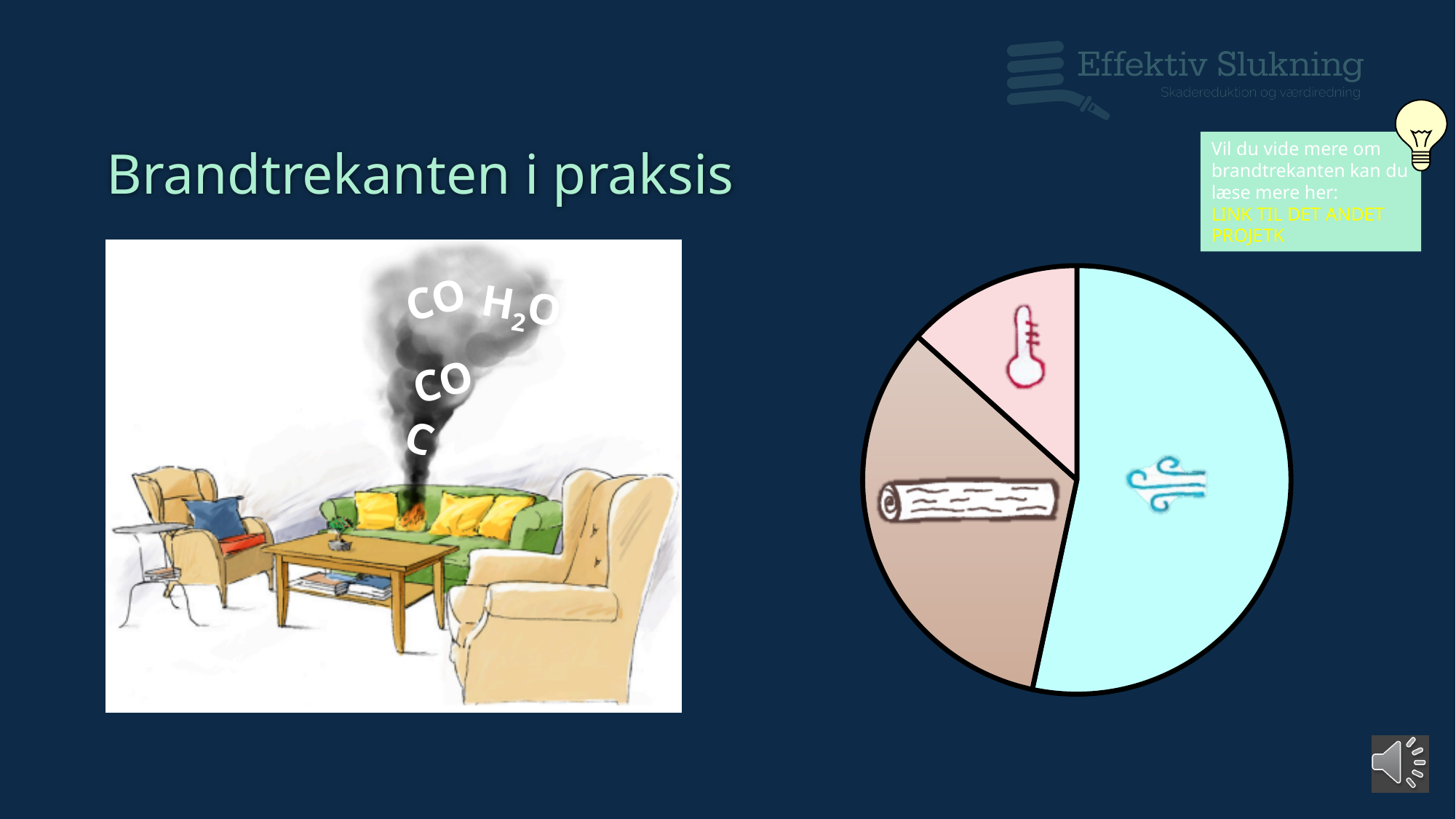
What is the title of the slide containing the pie chart? Brandtrekanten i praksis What icon is shown in the largest slice of the pie chart? a wind/air symbol How many slices does the pie chart have? 3 What kind of chart is shown on the right side of the slide? pie chart Does the light blue slice of the pie chart cover more or less than half of the pie? more In the pie chart, which is larger: the light blue slice or the tan slice? the light blue slice In the pie chart, which is larger: the tan slice with the log icon or the pink slice with the thermometer icon? the tan slice with the log icon Which slice of the pie chart is the largest? the light blue slice (wind icon) Which slice of the pie chart is the smallest? the pink slice (thermometer icon)